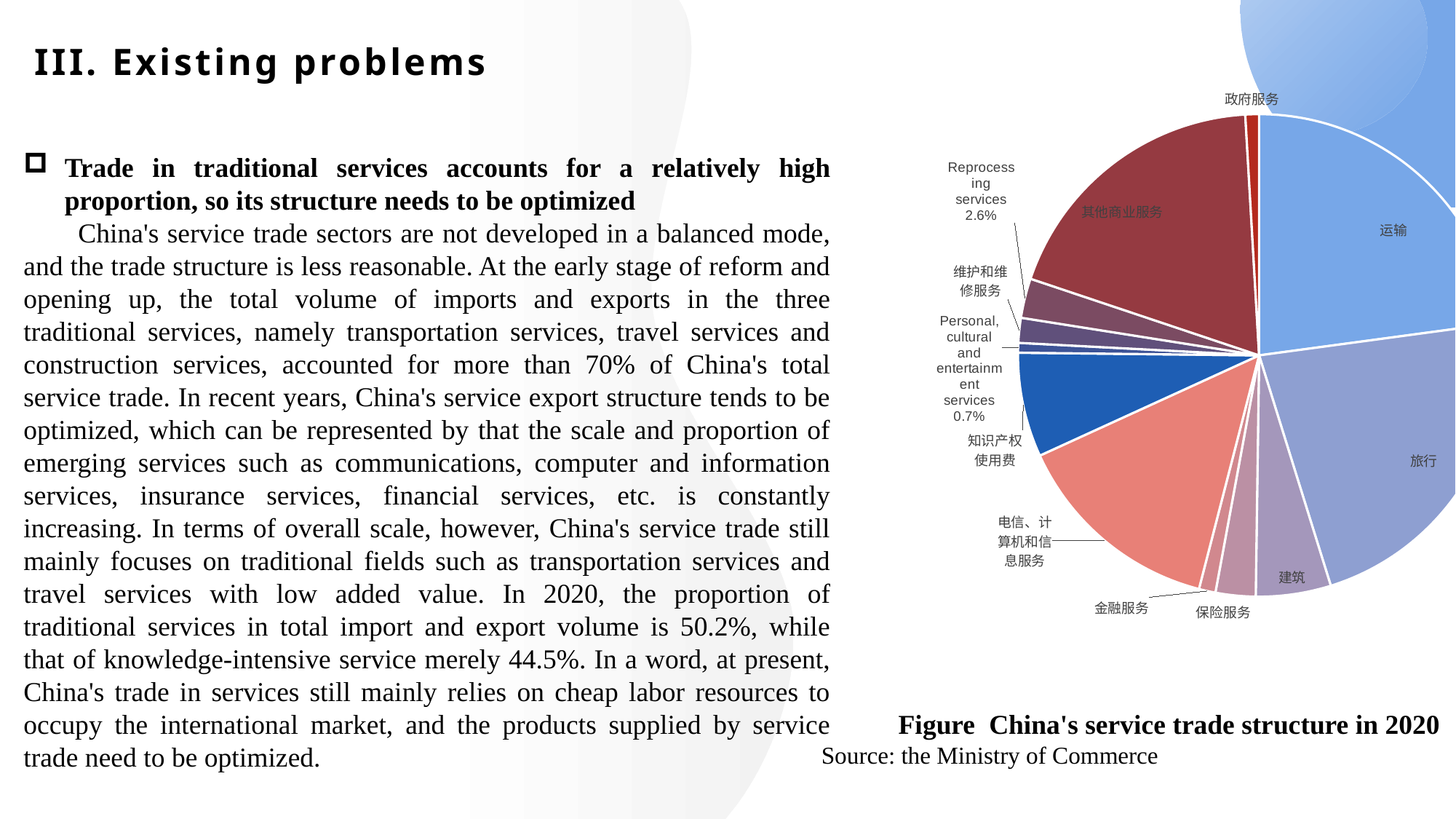
What is the share of Reprocessing services in the pie chart? 2.6% Which slice is larger, 电信、计算机和信息服务 or 建筑? 电信、计算机和信息服务 Which slice is larger, 其他商业服务 or 维护和维修服务? 其他商业服务 What is the title of the chart on the slide? Figure China's service trade structure in 2020 Which is larger in the pie chart, Reprocessing services or Personal, cultural and entertainment services? Reprocessing services What is the share of Personal, cultural and entertainment services in the pie chart? 0.7% What kind of chart is shown on the slide? pie chart What source is cited for the chart? the Ministry of Commerce By how many percentage points does the share of Reprocessing services exceed that of Personal, cultural and entertainment services? 1.9%